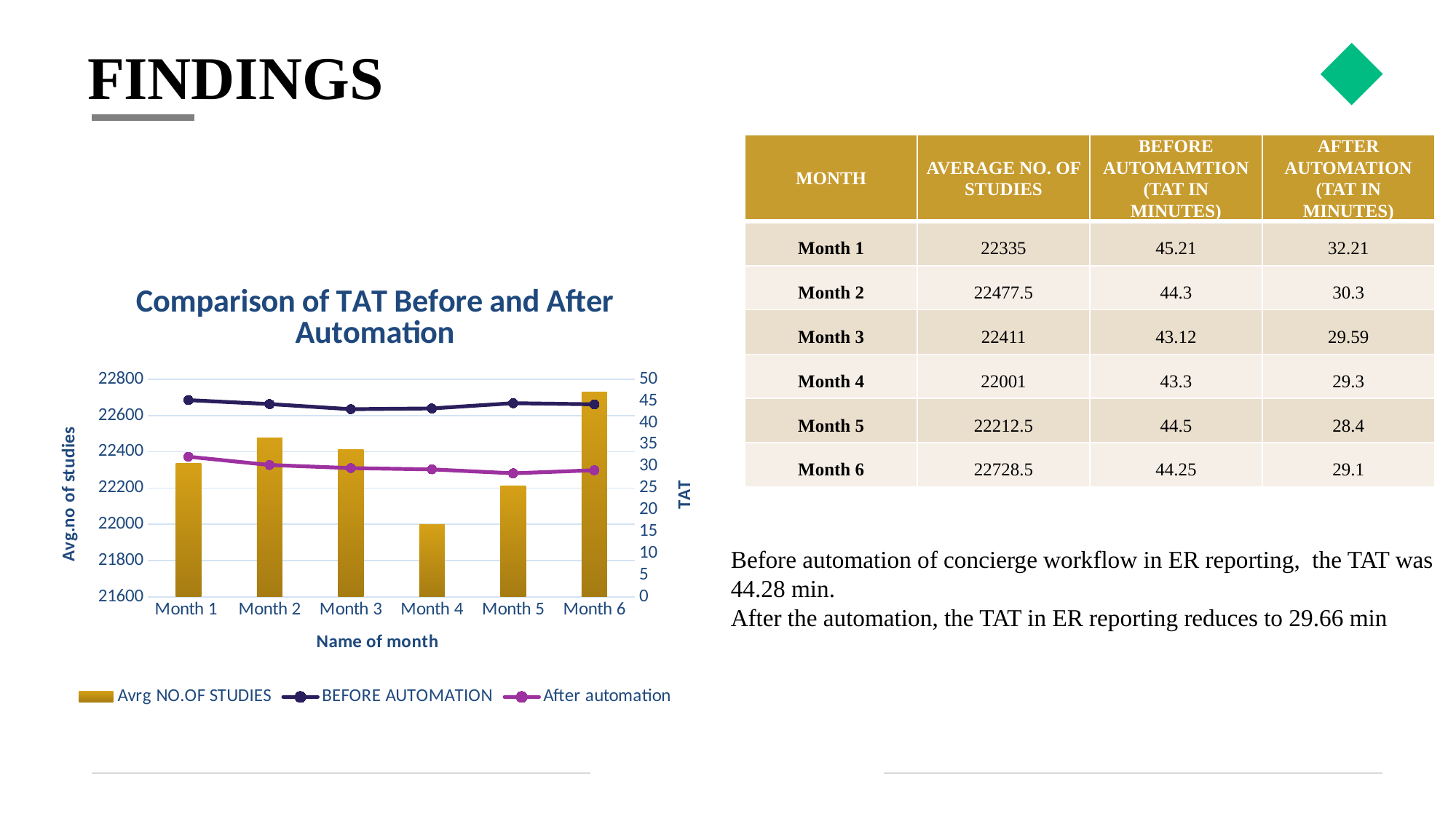
Is the BEFORE AUTOMATION value for Month 1 greater or less than 40? greater Which line is higher across all months, BEFORE AUTOMATION or After automation? BEFORE AUTOMATION What type of chart is used in 'Comparison of TAT Before and After Automation'? Combined bar and line chart Is the Avrg NO.OF STUDIES bar for Month 4 greater or less than 22200? less How many series does the chart legend list? 3 What is the label of the secondary (right) vertical axis of the chart? TAT Is the After automation value for Month 5 greater or less than 35? less Which month has the highest value on the After automation line? Month 1 Does the After automation line rise or fall from Month 1 to Month 6? Fall Which month has the tallest bar for Avrg NO.OF STUDIES? Month 6 How many months are shown on the x axis of the chart? 6 Which month has the shortest bar for Avrg NO.OF STUDIES? Month 4